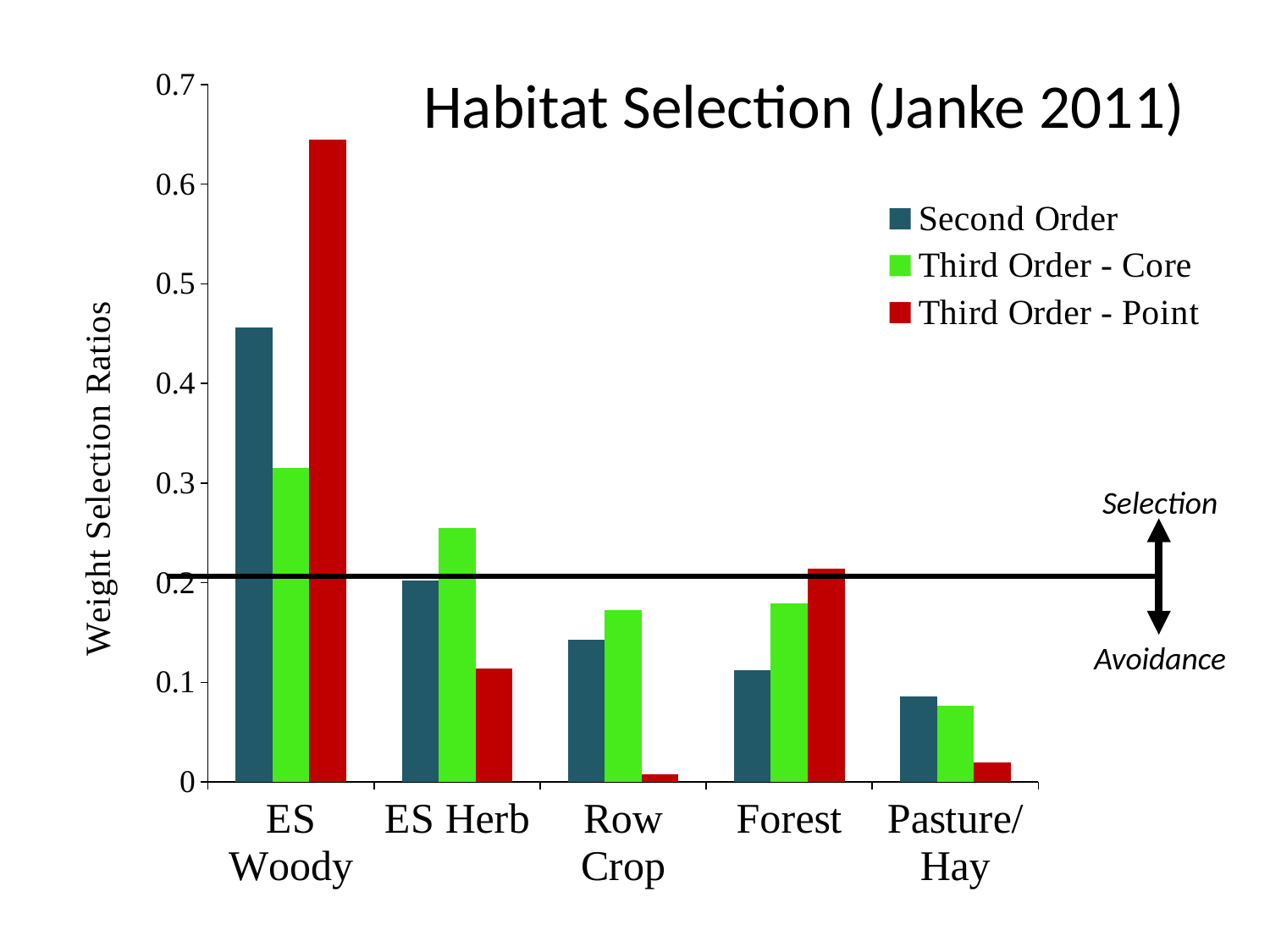
What kind of chart is shown on the slide? bar chart For Forest, which is larger: the Second Order value or the Third Order - Point value? Third Order - Point Is the Second Order value for ES Woody greater or less than 0.4? greater How many series does the legend list? 3 Which habitat category has the highest Third Order - Point value? ES Woody How many habitat categories are shown on the x axis? 5 What is the title of the chart? Habitat Selection (Janke 2011) For ES Herb, which is larger: the Second Order value or the Third Order - Core value? Third Order - Core Is the Third Order - Point value for ES Woody greater or less than 0.6? greater Which habitat category has the highest Third Order - Core value? ES Woody Is the Third Order - Point value for Row Crop greater or less than 0.1? less Which habitat category has the lowest Second Order value? Pasture/Hay